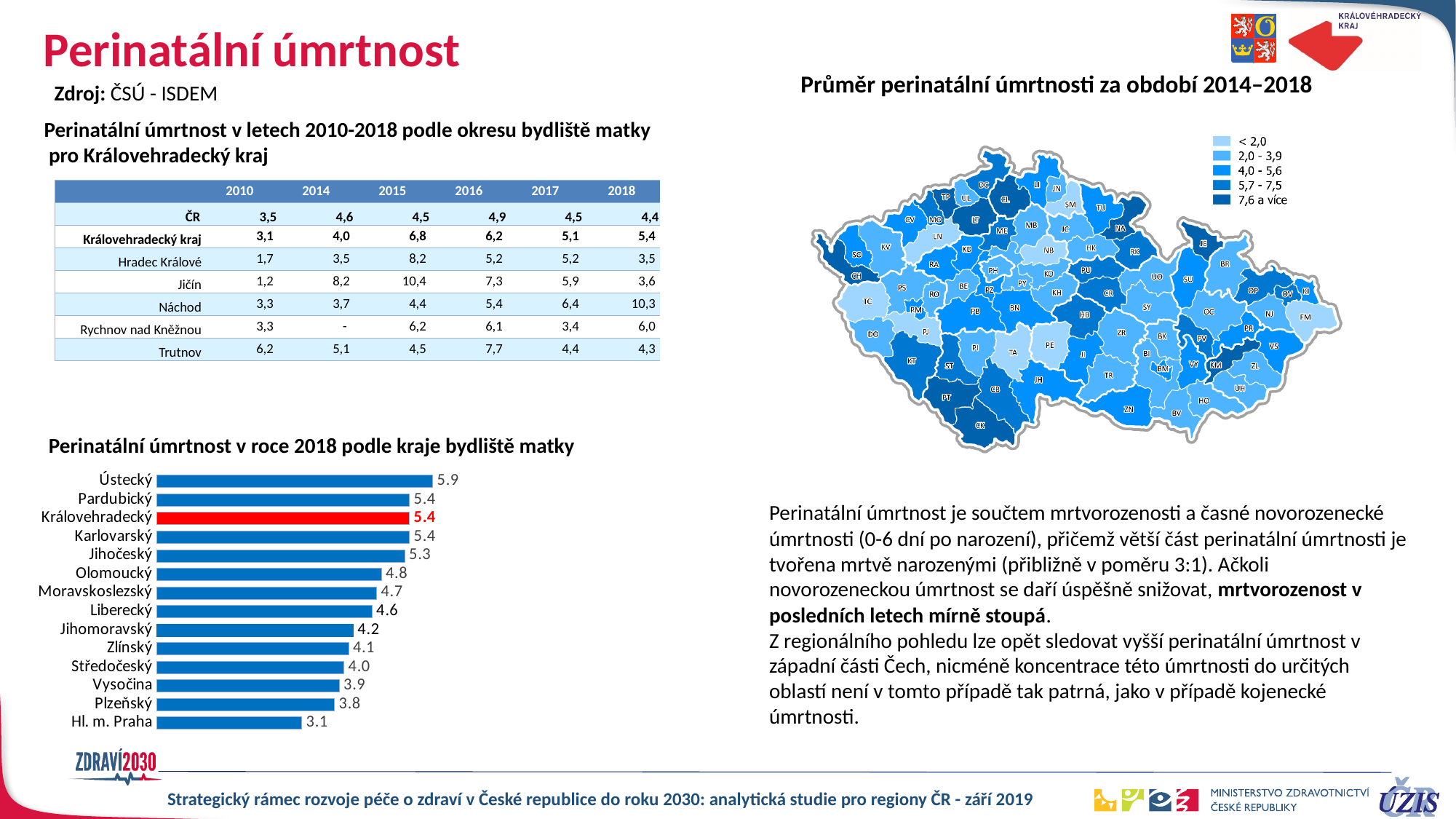
In the bar chart 'Perinatální úmrtnost v roce 2018 podle kraje bydliště matky', what is the difference between the values for Ústecký and Hl. m. Praha? 2.8 What kind of chart is 'Perinatální úmrtnost v roce 2018 podle kraje bydliště matky'? Bar chart In the bar chart 'Perinatální úmrtnost v roce 2018 podle kraje bydliště matky', what is the value for Královehradecký? 5.4 In the bar chart 'Perinatální úmrtnost v roce 2018 podle kraje bydliště matky', what is the value for Liberecký? 4.6 In the bar chart 'Perinatální úmrtnost v roce 2018 podle kraje bydliště matky', what is the value for Hl. m. Praha? 3.1 In the bar chart 'Perinatální úmrtnost v roce 2018 podle kraje bydliště matky', which region has the lowest value? Hl. m. Praha In the bar chart 'Perinatální úmrtnost v roce 2018 podle kraje bydliště matky', which is larger, the value for Jihočeský or the value for Zlínský? Jihočeský In the bar chart 'Perinatální úmrtnost v roce 2018 podle kraje bydliště matky', which region's bar is highlighted in red? Královehradecký In the bar chart 'Perinatální úmrtnost v roce 2018 podle kraje bydliště matky', what is the difference between the values for Olomoucký and Vysočina? 0.9 In the bar chart 'Perinatální úmrtnost v roce 2018 podle kraje bydliště matky', which region has the highest value? Ústecký In the bar chart 'Perinatální úmrtnost v roce 2018 podle kraje bydliště matky', what is the value for Ústecký? 5.9 How many regions are shown in the bar chart 'Perinatální úmrtnost v roce 2018 podle kraje bydliště matky'? 14